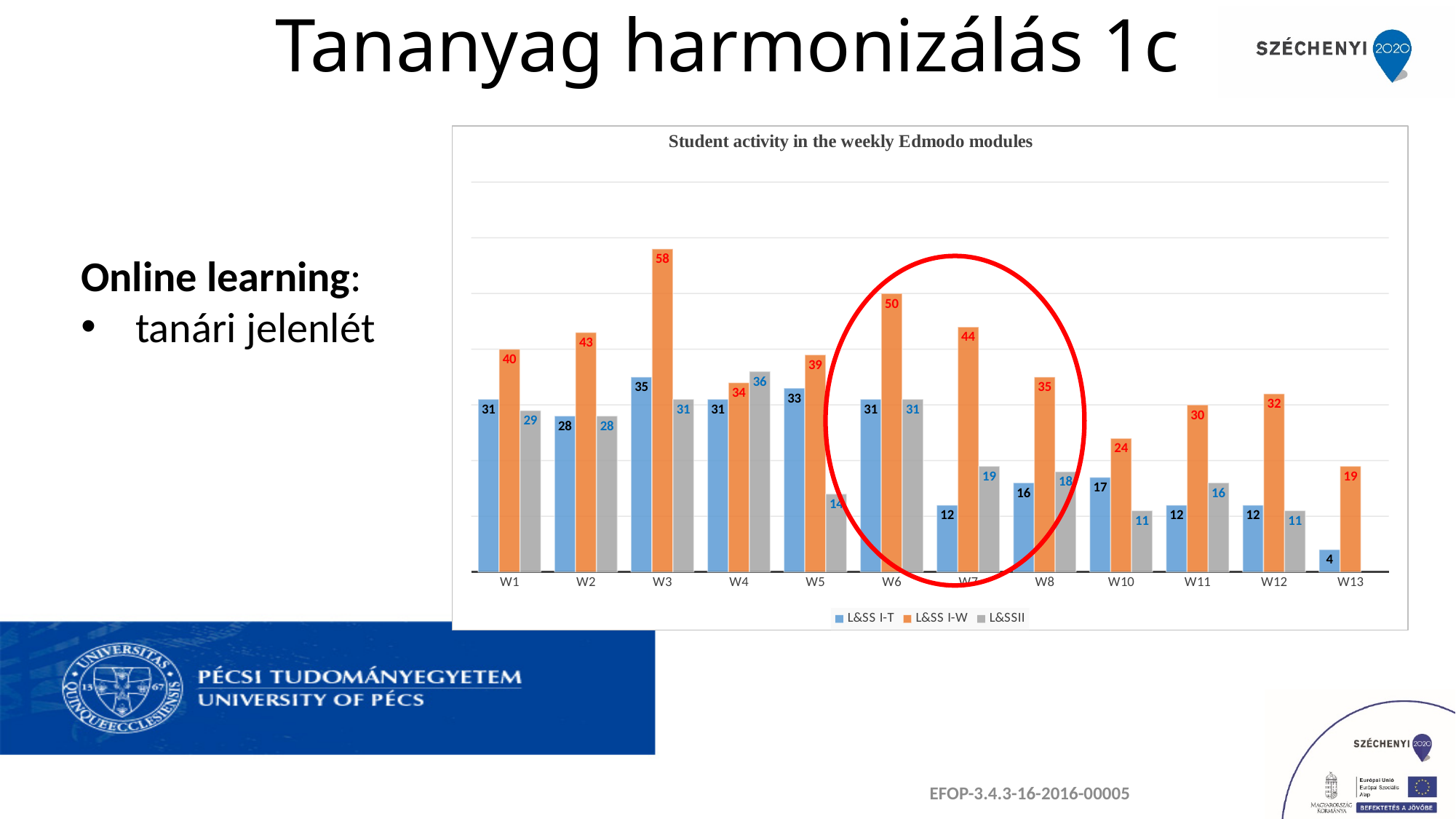
How many series does the legend list? 3 What is the value of L&SSII in W4? 36 What is the difference between L&SS I-W and L&SS I-T in W6? 19 What is the value of L&SS I-T in W13? 4 In W4, which series has the larger value: L&SSII or L&SS I-W? L&SSII In which week is the L&SS I-T value lowest? W13 How many weeks are shown on the x axis? 12 What is the title of the chart? Student activity in the weekly Edmodo modules What is the value of L&SS I-W in W7? 44 What is the value of L&SS I-W in W3? 58 What kind of chart is shown? Bar chart In which week is the L&SS I-W value highest? W3